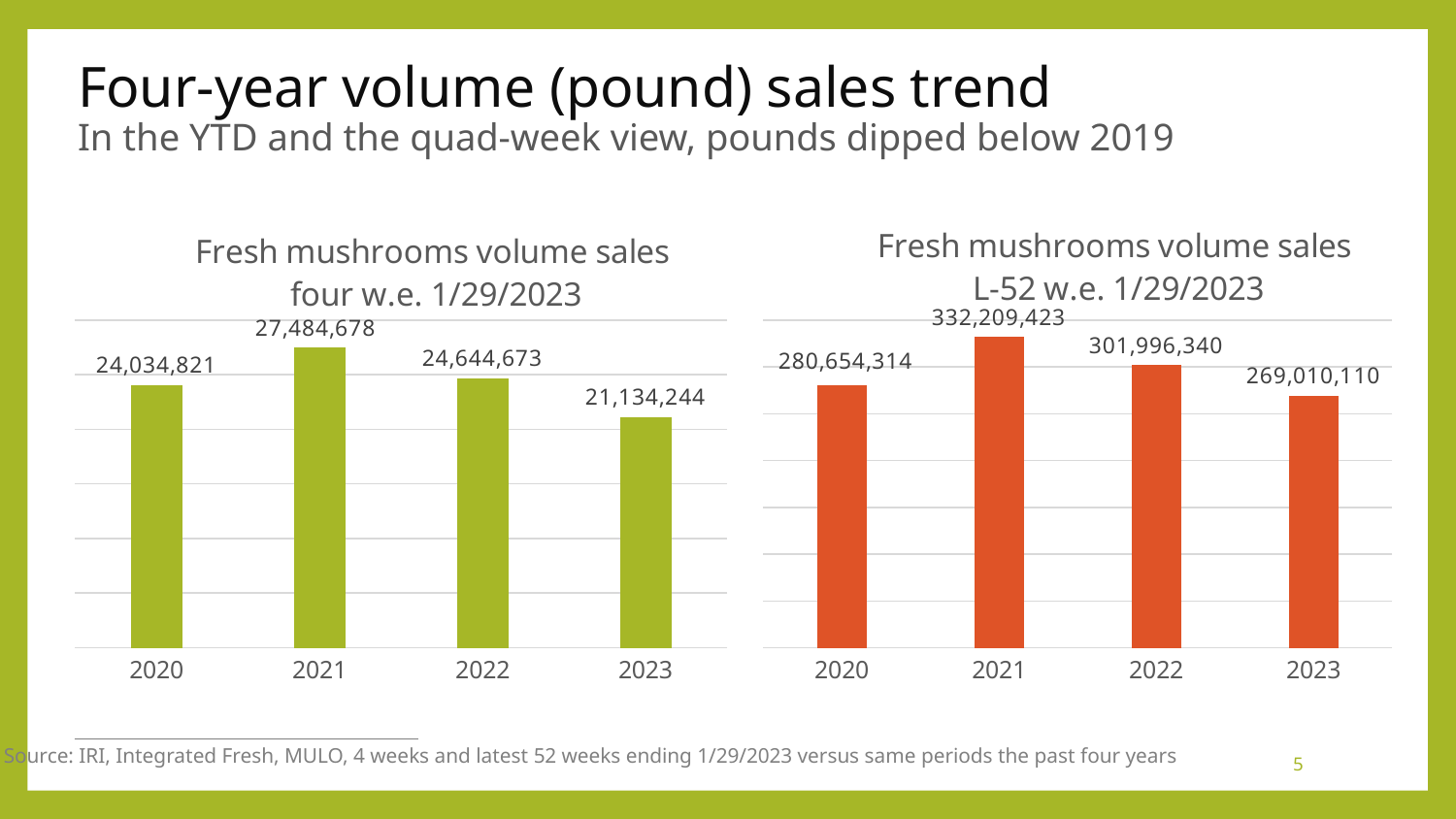
In the 'Fresh mushrooms volume sales four w.e. 1/29/2023' chart, which is larger, the value for 2020 or the value for 2022? 2022 In the 'Fresh mushrooms volume sales L-52 w.e. 1/29/2023' chart, which year has the lowest value? 2023 How many years are shown in the 'Fresh mushrooms volume sales L-52 w.e. 1/29/2023' chart? 4 In the 'Fresh mushrooms volume sales four w.e. 1/29/2023' chart, what is the value for 2021? 27,484,678 In the 'Fresh mushrooms volume sales four w.e. 1/29/2023' chart, which year has the highest value? 2021 In the 'Fresh mushrooms volume sales L-52 w.e. 1/29/2023' chart, what is the value for 2020? 280,654,314 In the 'Fresh mushrooms volume sales four w.e. 1/29/2023' chart, what is the difference between the 2021 and 2023 values? 6,350,434 What type of chart is the 'Fresh mushrooms volume sales four w.e. 1/29/2023' chart? Bar chart In the 'Fresh mushrooms volume sales four w.e. 1/29/2023' chart, what is the value for 2023? 21,134,244 In the 'Fresh mushrooms volume sales L-52 w.e. 1/29/2023' chart, do the values rise or fall from 2021 to 2023? Fall In the 'Fresh mushrooms volume sales L-52 w.e. 1/29/2023' chart, what is the difference between the 2021 and 2022 values? 30,213,083 In the 'Fresh mushrooms volume sales L-52 w.e. 1/29/2023' chart, what is the value for 2022? 301,996,340